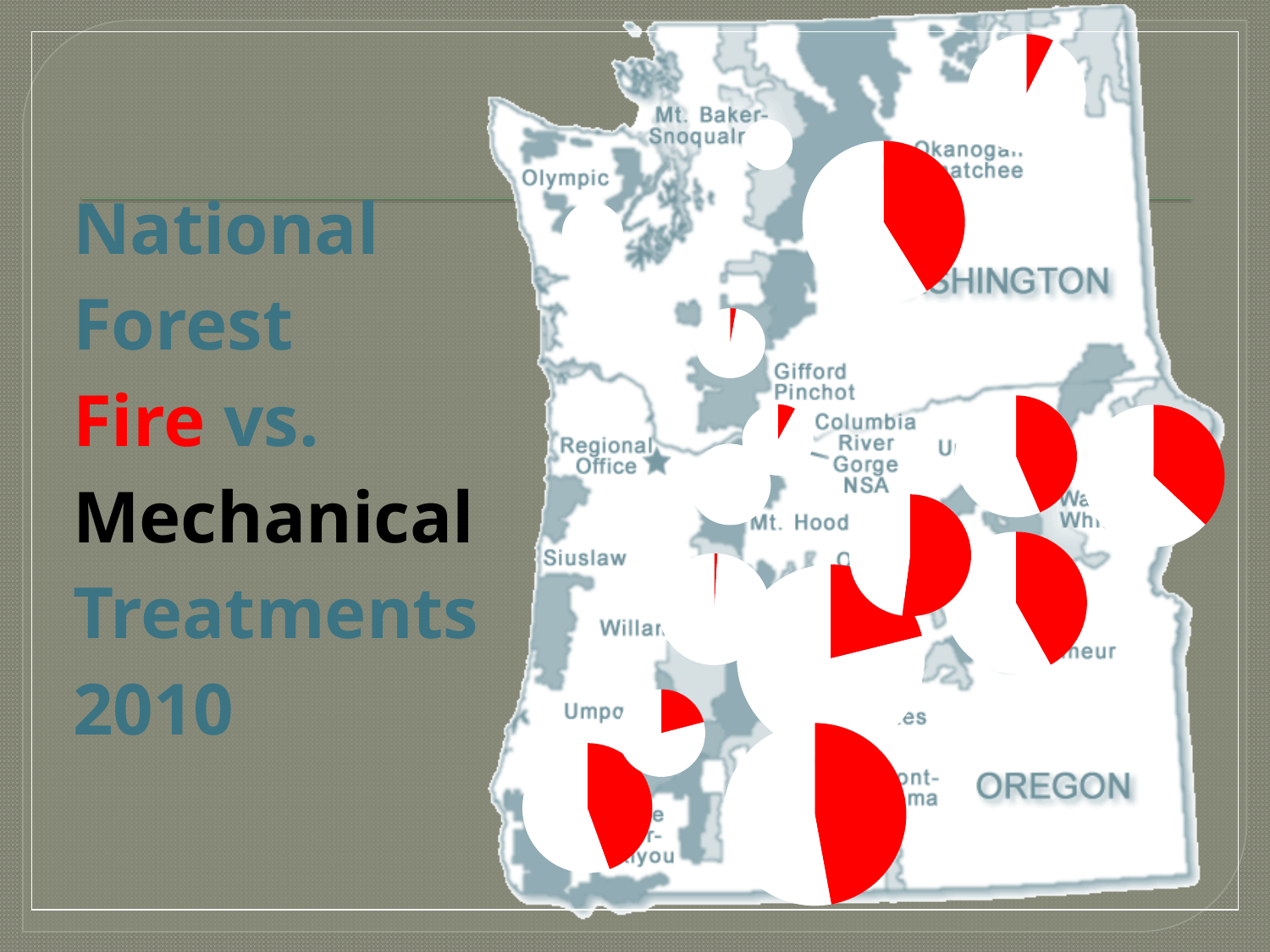
What is the title of the slide containing the pie charts? National Forest Fire vs. Mechanical Treatments 2010 Which pie chart has a larger red share: the one over Gifford Pinchot or the large one near the Okanogan-Wenatchee label? The one near Okanogan-Wenatchee What kind of chart is overlaid on the map of Washington and Oregon? Pie chart Which pie chart has a larger red share: the one over Olympic or the large one near the Okanogan-Wenatchee label? The one near Okanogan-Wenatchee Which pie chart has a larger red share: the one over Siuslaw or the large one near the Okanogan-Wenatchee label? The one near Okanogan-Wenatchee What two colours are used for the slices in the pie charts on the map? Red and white